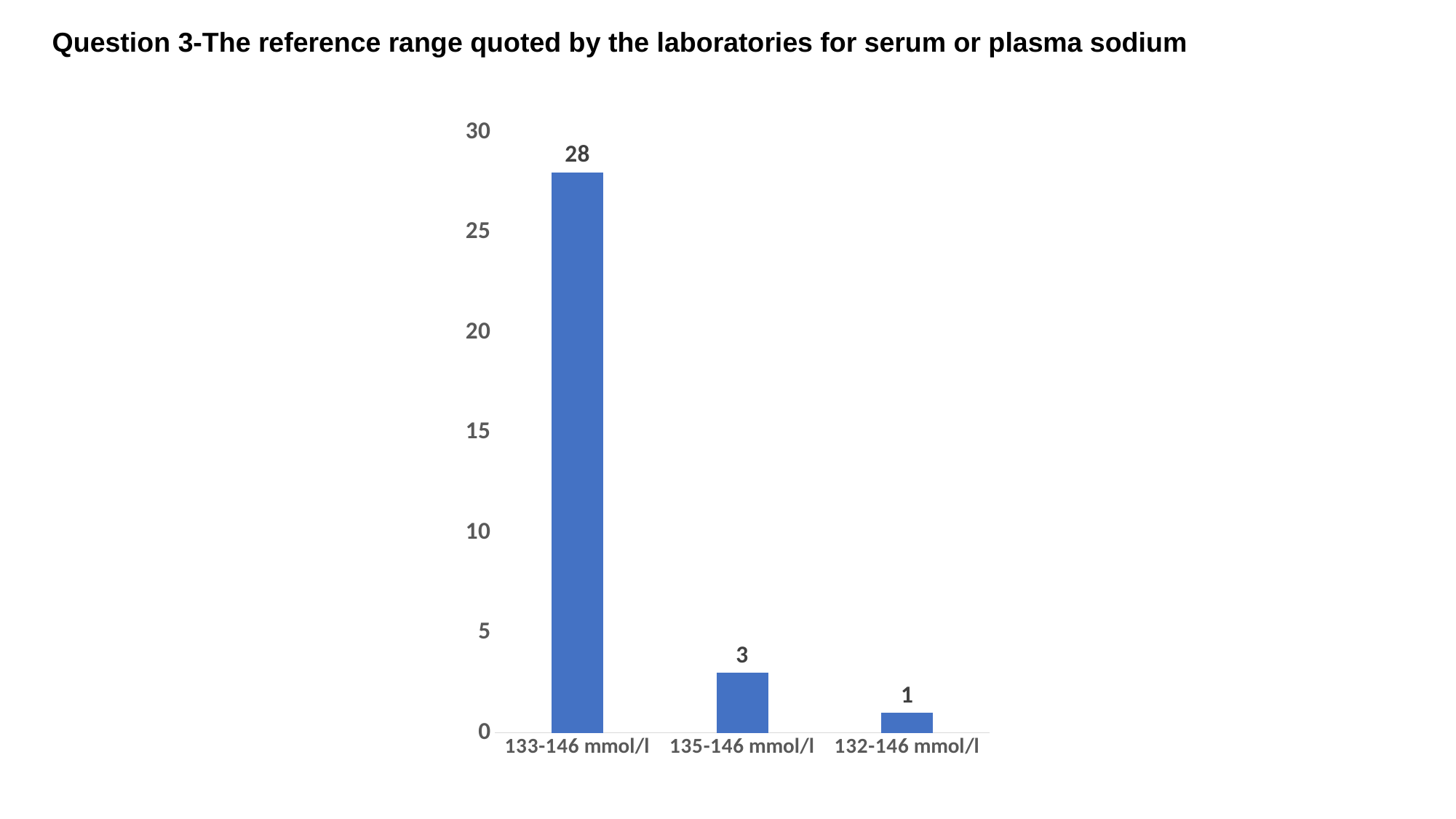
What is the difference between the values for 135-146 mmol/l and 132-146 mmol/l? 2 What is the value for 133-146 mmol/l? 28 How many reference range categories are shown on the chart? 3 Is the value for 133-146 mmol/l greater or less than 25? greater Which reference range has the lowest value? 132-146 mmol/l Which reference range has the highest value? 133-146 mmol/l What kind of chart is shown on the slide? bar chart Which is larger, the value for 135-146 mmol/l or the value for 132-146 mmol/l? 135-146 mmol/l What is the value for 135-146 mmol/l? 3 What is the difference between the values for 133-146 mmol/l and 135-146 mmol/l? 25 What is the title of the slide? Question 3-The reference range quoted by the laboratories for serum or plasma sodium What is the value for 132-146 mmol/l? 1